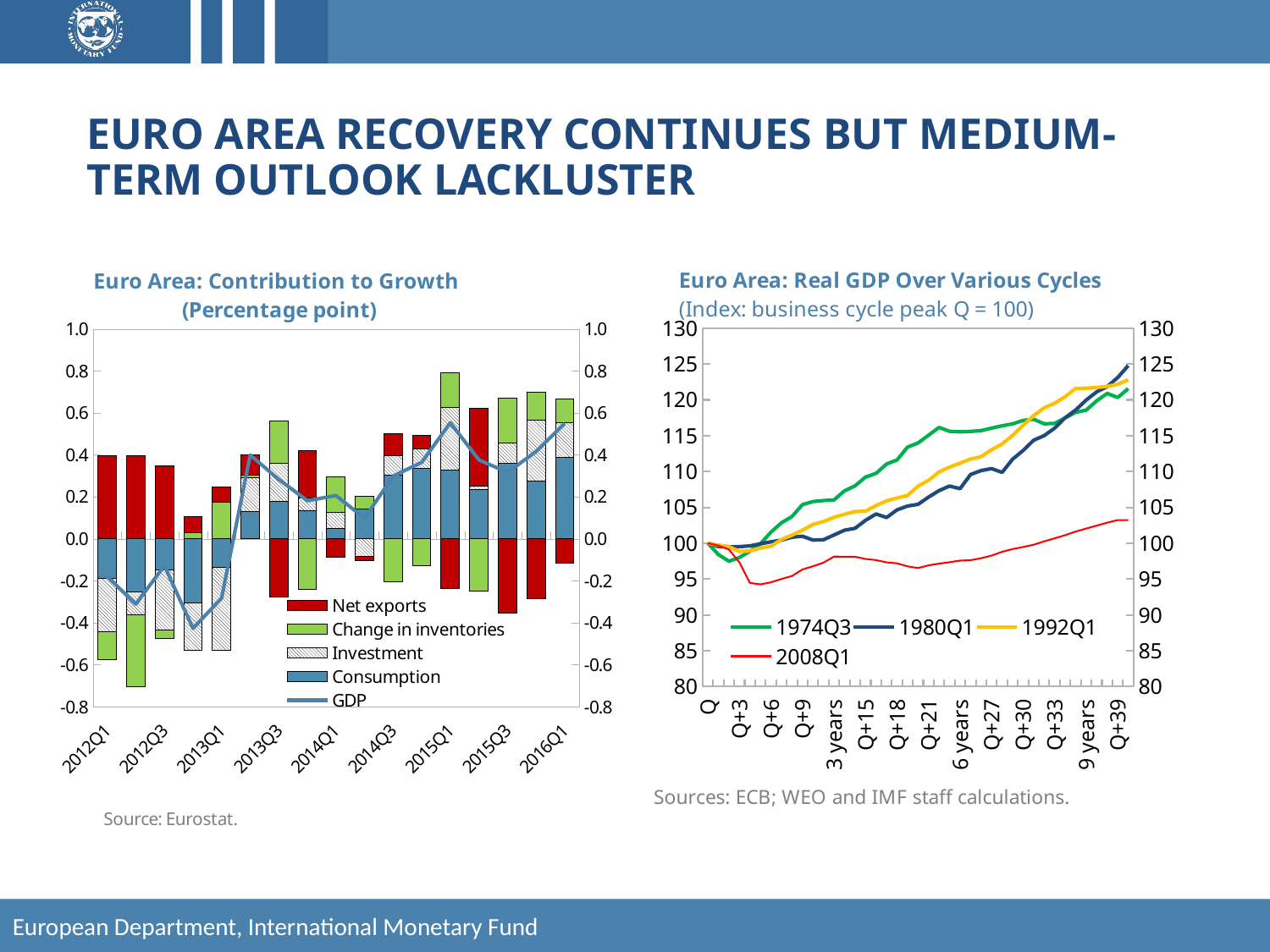
How many series does the legend of the 'Euro Area: Real GDP Over Various Cycles' chart list? 4 In the 'Euro Area: Real GDP Over Various Cycles' chart, is the value of the 2008Q1 series at Q+39 greater or less than 105? less In the 'Euro Area: Contribution to Growth' chart, is the GDP line at 2013Q1 greater or less than 0.0? less What kind of chart is the 'Euro Area: Real GDP Over Various Cycles' chart? Line chart In the 'Euro Area: Real GDP Over Various Cycles' chart, does the 1980Q1 series rise or fall from Q to Q+39? Rise In the 'Euro Area: Real GDP Over Various Cycles' chart, which series is highest at Q+39? 1980Q1 In the 'Euro Area: Real GDP Over Various Cycles' chart, which is larger at Q+39: the 1980Q1 series or the 2008Q1 series? 1980Q1 How many series does the legend of the 'Euro Area: Contribution to Growth' chart list? 5 What is the index value at the business cycle peak Q in the 'Euro Area: Real GDP Over Various Cycles' chart? 100 In the 'Euro Area: Real GDP Over Various Cycles' chart, is the value of the 1980Q1 series at Q+39 greater or less than 120? greater What kind of chart is the 'Euro Area: Contribution to Growth' chart? Combination bar and line chart (stacked bars with a GDP line) In the 'Euro Area: Real GDP Over Various Cycles' chart, which series is lowest at Q+39? 2008Q1